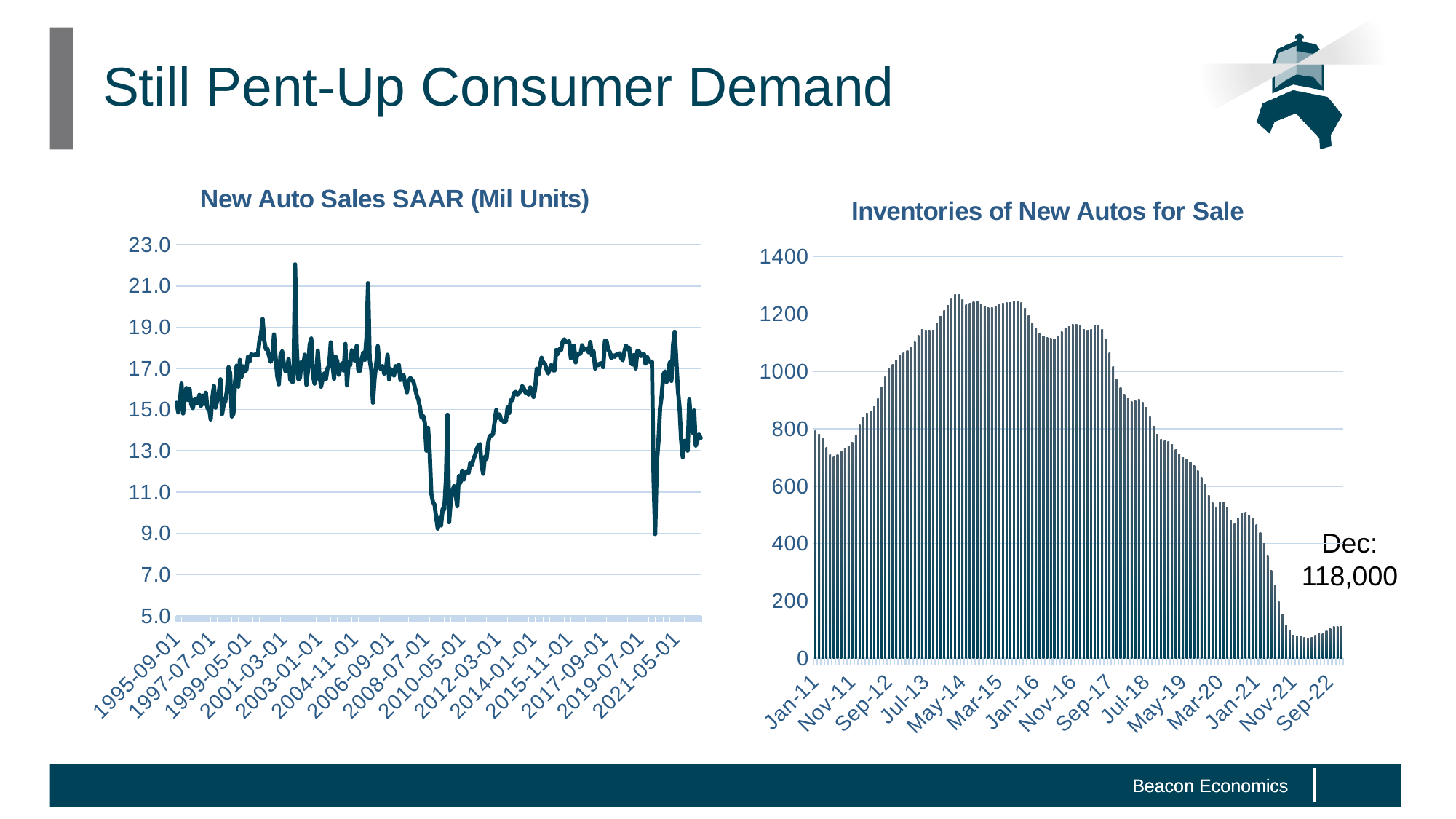
In the 'Inventories of New Autos for Sale' chart, is the peak value around May-14 greater or less than 1200? greater In the 'New Auto Sales SAAR (Mil Units)' chart, is the value at 1995-09-01 greater or less than 13.0? greater In the 'Inventories of New Autos for Sale' chart, is the value at Sep-22 greater or less than 200? less What kind of chart is the 'Inventories of New Autos for Sale' chart on the right? bar chart In the 'Inventories of New Autos for Sale' chart, which is larger: the value at May-14 or the value at Sep-22? May-14 In the 'Inventories of New Autos for Sale' chart, what value is annotated for Dec? 118,000 What is the title of the chart on the right side of the slide? Inventories of New Autos for Sale In the 'Inventories of New Autos for Sale' chart, do the values rise or fall between Jul-18 and Nov-21? fall What kind of chart is the 'New Auto Sales SAAR (Mil Units)' chart on the left? line chart